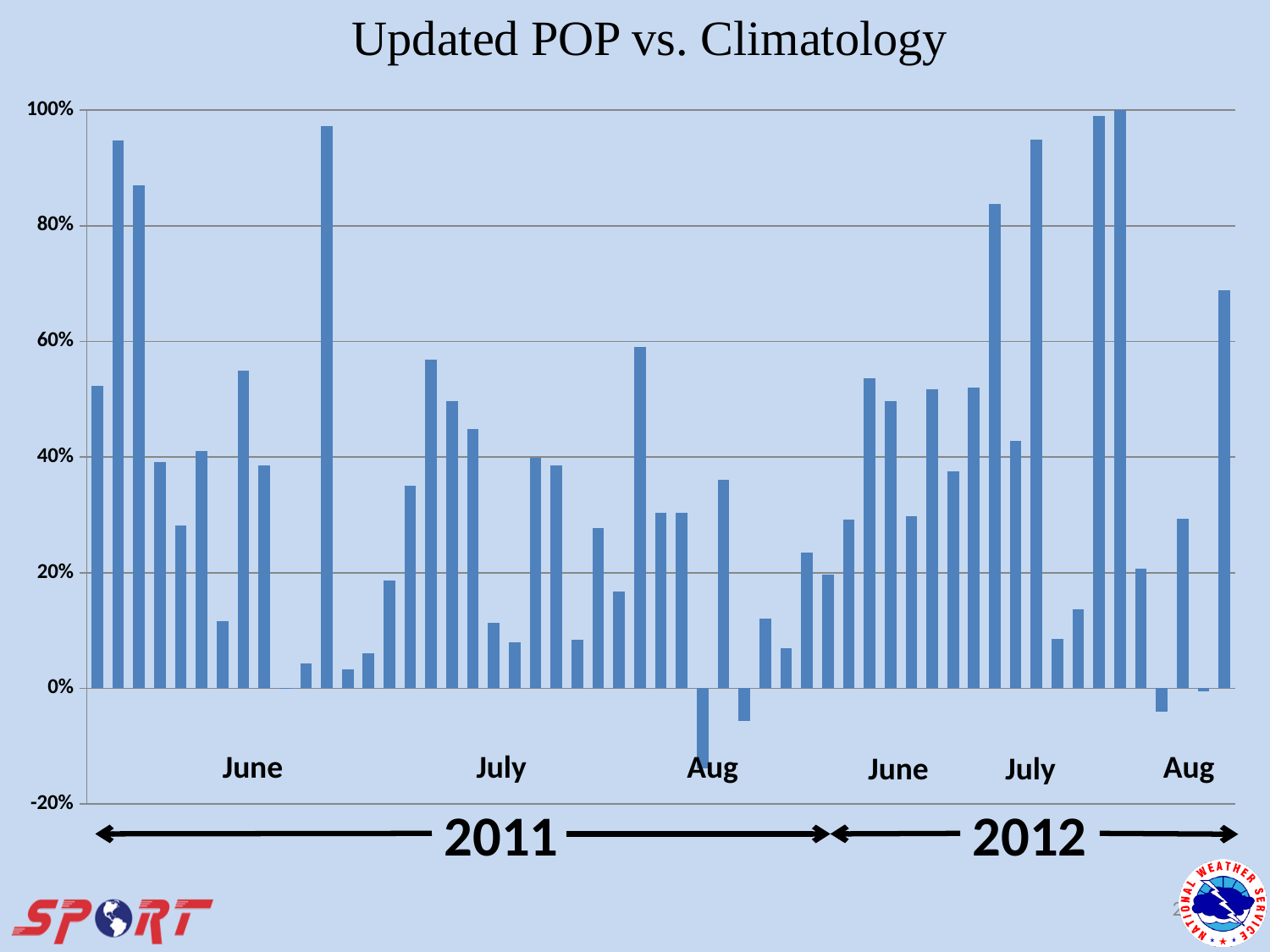
What is the title of the chart? Updated POP vs. Climatology What kind of chart is shown on the slide? bar chart Are there any bars on the chart that fall below 0%? yes Is the tallest bar in the 2011 section greater or less than 80%? greater In which year does the lowest (most negative) bar on the chart occur? 2011 Is the lowest bar on the chart greater or less than -10%? less Is the tallest bar in the 2012 section greater or less than 80%? greater Which two years are labeled along the bottom of the chart? 2011 and 2012 How many years of data does the chart cover? 2 Which month label appears in both the 2011 and 2012 sections immediately before Aug? July